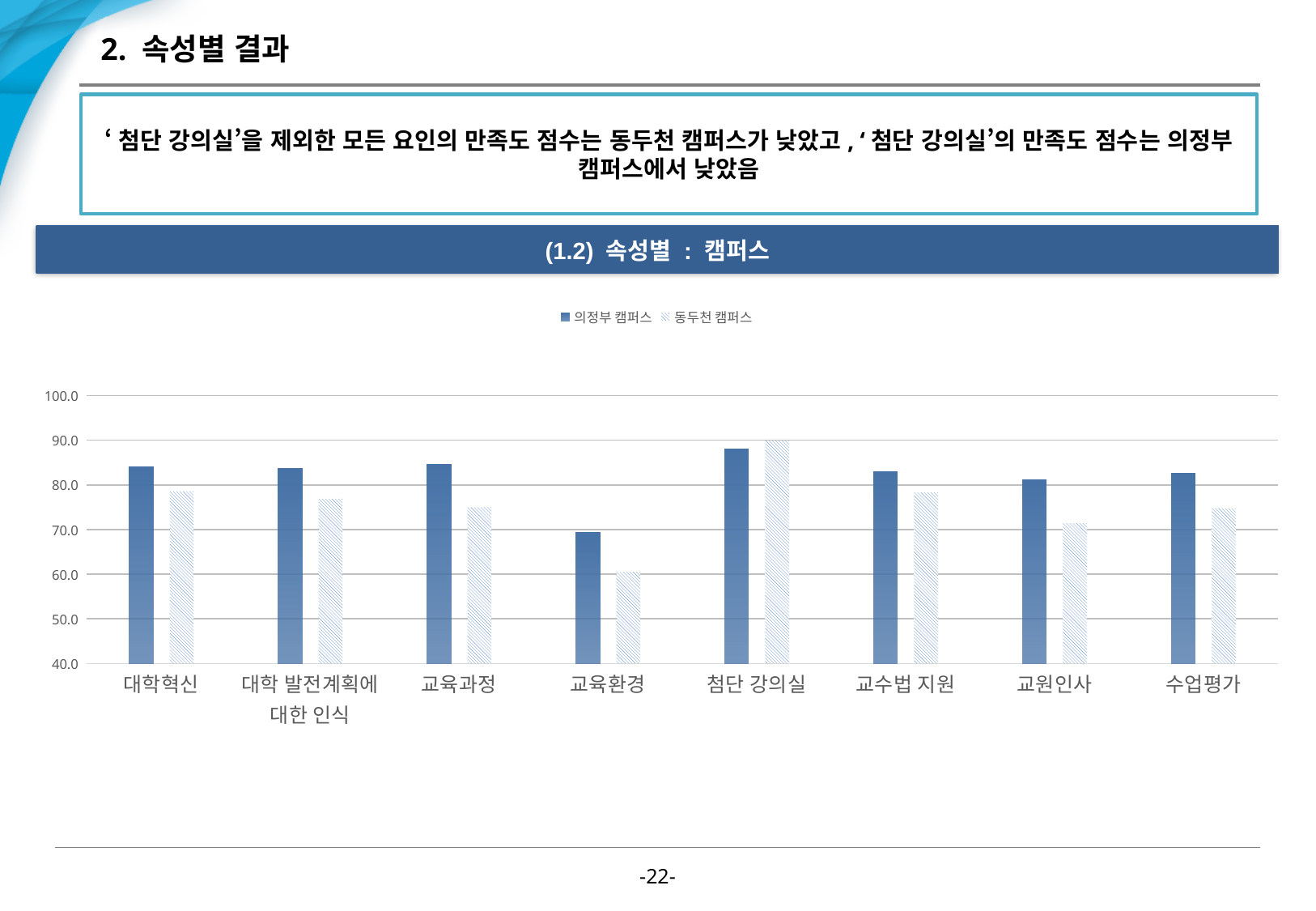
For which category is the 동두천 캠퍼스 value lowest? 교육환경 How many categories are shown on the x axis of the chart? 8 How many series does the chart legend list? 2 For 교육환경, which campus has the larger value, 의정부 캠퍼스 or 동두천 캠퍼스? 의정부 캠퍼스 Is the 동두천 캠퍼스 value for 교육환경 greater or less than 70? less Which two series are listed in the chart legend? 의정부 캠퍼스, 동두천 캠퍼스 For which category is the 동두천 캠퍼스 value highest? 첨단 강의실 For 첨단 강의실, which campus has the larger value, 의정부 캠퍼스 or 동두천 캠퍼스? 동두천 캠퍼스 Is the 의정부 캠퍼스 value for 대학혁신 greater or less than 80? greater What kind of chart is shown on the slide? bar chart What is the title of the section containing the chart? (1.2) 속성별 : 캠퍼스 For which category is the 의정부 캠퍼스 value lowest? 교육환경